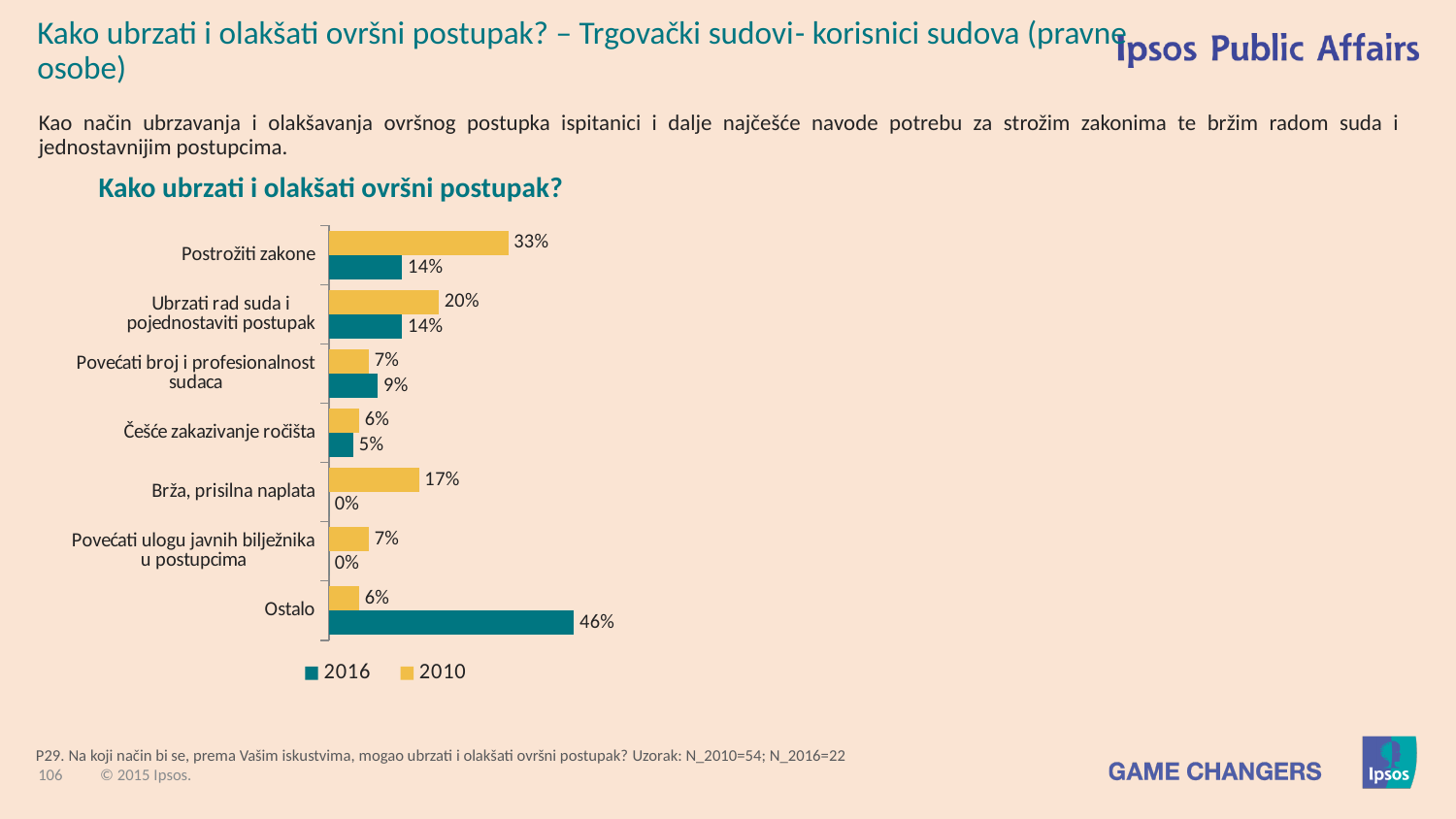
What is the 2010 value for "Postrožiti zakone"? 33% Which colour represents the 2016 series in the chart? Teal How many categories are shown in the chart? 7 What type of chart is shown on the slide? Bar chart Which category has the highest 2016 value? Ostalo What is the difference between the 2010 and 2016 values for "Postrožiti zakone"? 19 percentage points What is the 2016 value for "Ostalo"? 46% Which category has the highest 2010 value? Postrožiti zakone How many series does the legend list? 2 Which is larger for "Povećati broj i profesionalnost sudaca": the 2010 value or the 2016 value? 2016 What is the 2010 value for "Ubrzati rad suda i pojednostaviti postupak"? 20% What is the 2016 value for "Brža, prisilna naplata"? 0%